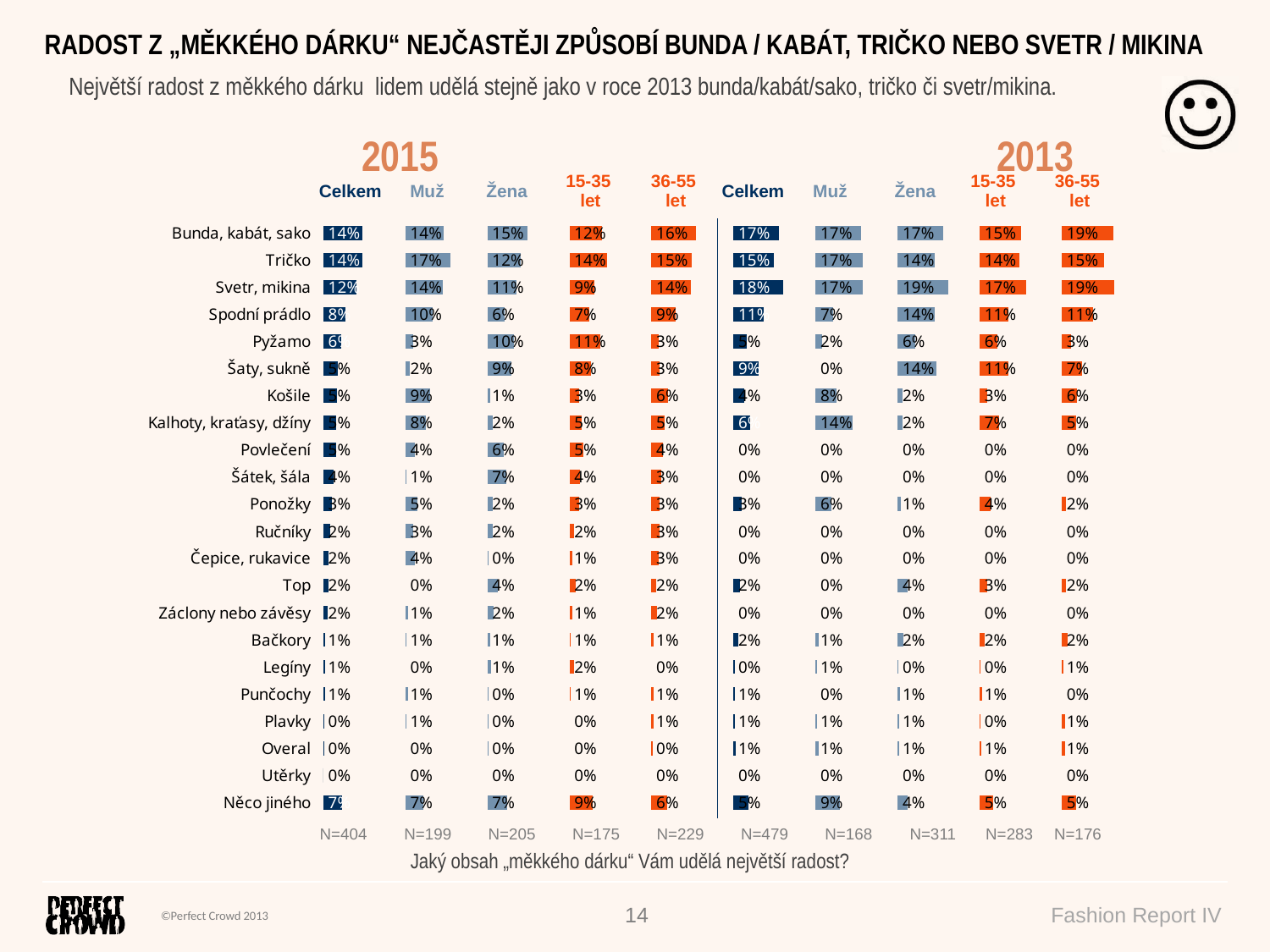
How many columns (series) are shown under the 2015 heading? 5 In the 2013 chart, which is larger for Šaty, sukně: the Žena value or the Muž value? Žena In the 2013 chart, which category has the highest Celkem value? Svetr, mikina In the 2015 chart, what is the difference between the 36-55 let and 15-35 let values for Bunda, kabát, sako? 4% In the 2015 chart, which is larger for Svetr, mikina: the 15-35 let value or the 36-55 let value? 36-55 let In the 2015 chart, what is the Celkem value for Bunda, kabát, sako? 14% In the 2015 chart, which category has the highest Muž value? Tričko What is the sample size (N) for the 2013 Celkem column? N=479 In the 2013 chart, what is the Muž value for Kalhoty, kraťasy, džíny? 14% In the 2013 chart, what is the Celkem value for Svetr, mikina? 18% In the 2015 chart, what is the Žena value for Pyžamo? 10% What type of chart is used to display the values on this slide? Bar chart